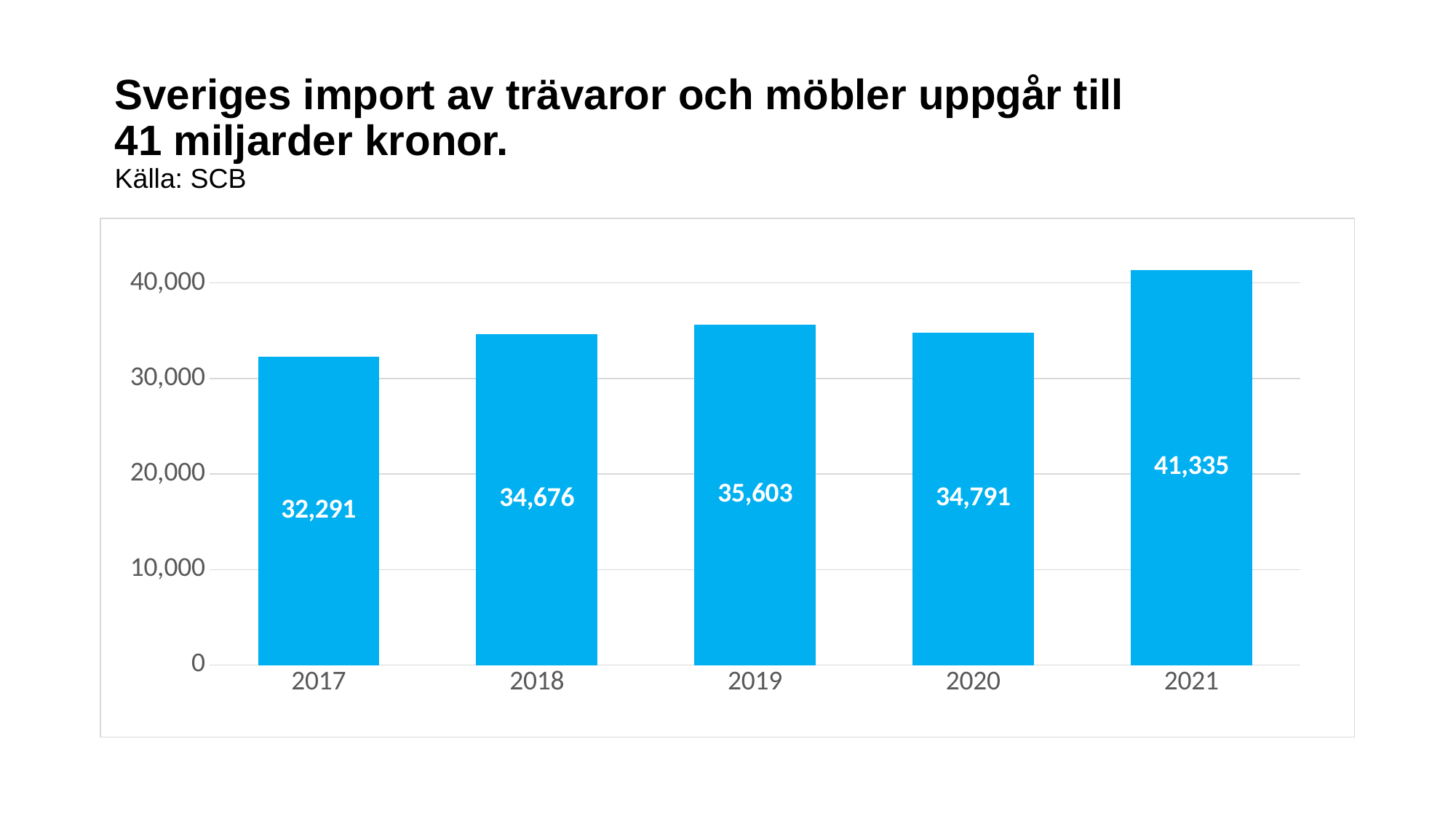
Which year has the lowest value? 2017 Which year has the highest value? 2021 What kind of chart is shown on the slide? bar chart What is the difference between the values for 2021 and 2020? 6,544 What is the value for 2017? 32,291 What is the value for 2021? 41,335 What source is cited below the title? SCB What is the difference between the values for 2018 and 2017? 2,385 Which is larger, the value for 2019 or the value for 2020? 2019 How many years are shown on the x axis? 5 What is the value for 2019? 35,603 Is the value for 2021 greater or less than 40,000? greater